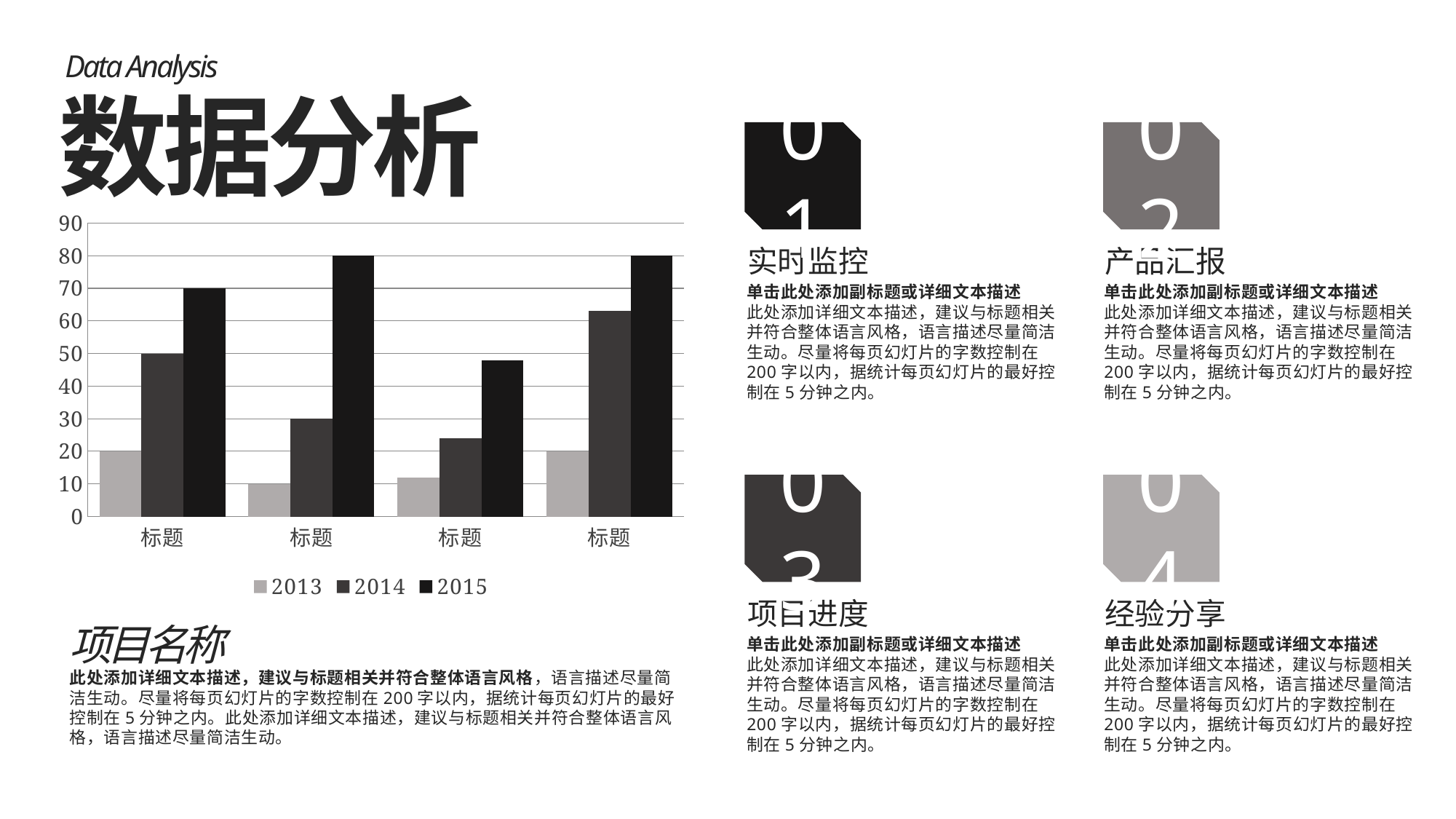
Which years are listed in the chart legend? 2013, 2014, 2015 What kind of chart is shown on the slide? bar chart In the second category group from the left, what is the value of the 2015 bar? 80 In the second category group from the left, what is the value of the 2013 bar? 10 In the first (leftmost) category group, what is the difference between the 2015 bar and the 2013 bar? 50 In the first (leftmost) category group, what is the value of the 2015 bar? 70 In the first (leftmost) category group, what is the value of the 2014 bar? 50 Which series has the tallest bar in the third category group from the left? 2015 How many series does the chart legend list? 3 Which is larger: the 2015 bar in the second category group or the 2015 bar in the third category group? the second category group How many category groups are plotted along the x axis of the chart? 4 Is the value of the 2014 bar in the fourth (rightmost) category group greater or less than 60? greater